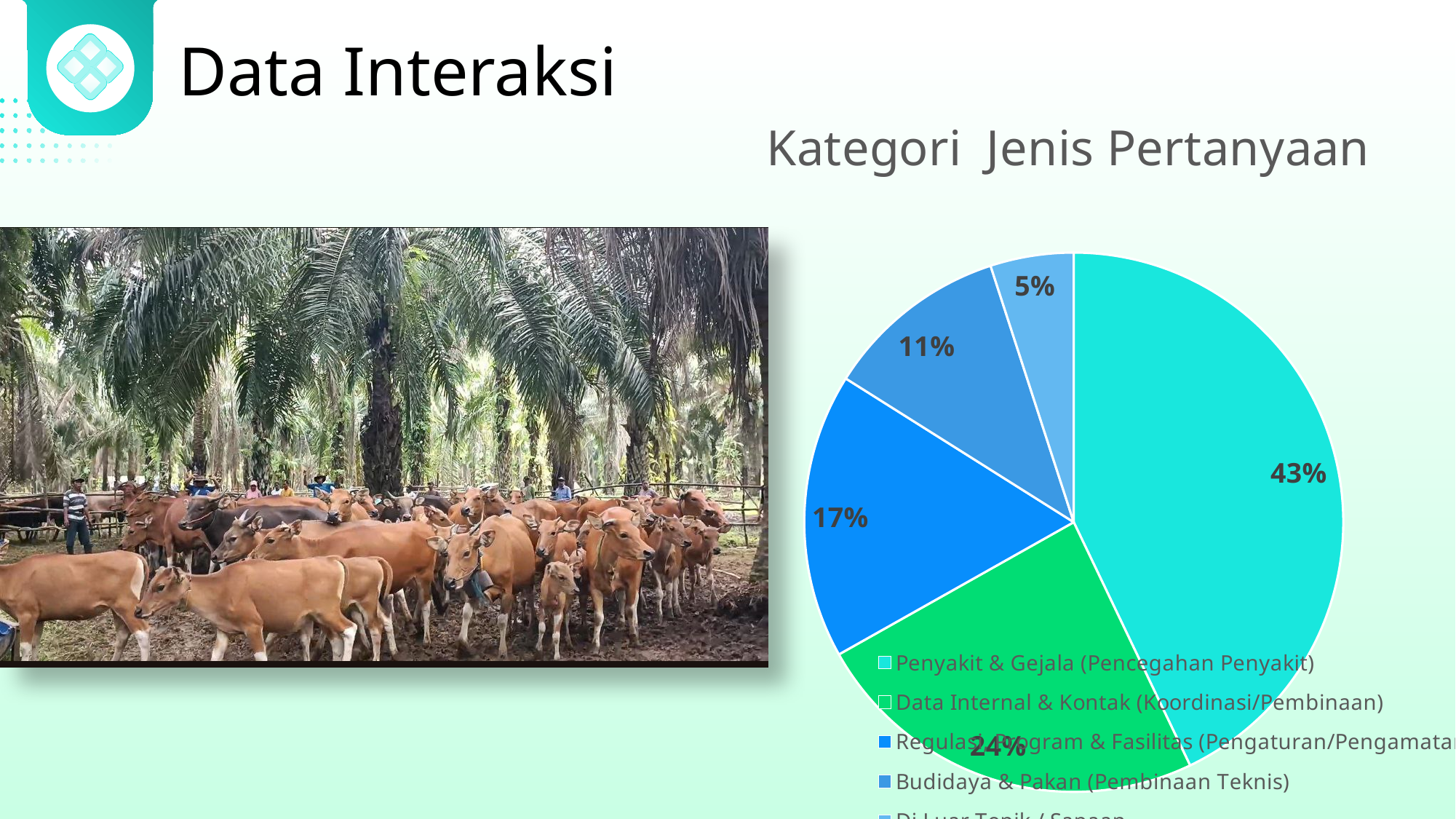
What is the difference between the 17% slice and the 11% slice in the pie chart? 6 percentage points How many percentage points larger is the "Penyakit & Gejala" slice than the "Data Internal & Kontak" slice? 19 percentage points What type of chart is shown under the heading "Kategori Jenis Pertanyaan"? Pie chart What is the percentage of the smallest slice in the pie chart? 5% How many entries does the pie chart's legend list? 5 What is the title of the pie chart? Kategori Jenis Pertanyaan How many slices does the pie chart have? 5 Which slice is larger: "Data Internal & Kontak (Koordinasi/Pembinaan)" or "Budidaya & Pakan (Pembinaan Teknis)"? Data Internal & Kontak (Koordinasi/Pembinaan) What percentage does the "Data Internal & Kontak (Koordinasi/Pembinaan)" slice show? 24% What percentage is shown for "Budidaya & Pakan (Pembinaan Teknis)"? 11% What percentage of the pie chart is "Penyakit & Gejala (Pencegahan Penyakit)"? 43% Which category has the largest slice of the pie chart? Penyakit & Gejala (Pencegahan Penyakit)